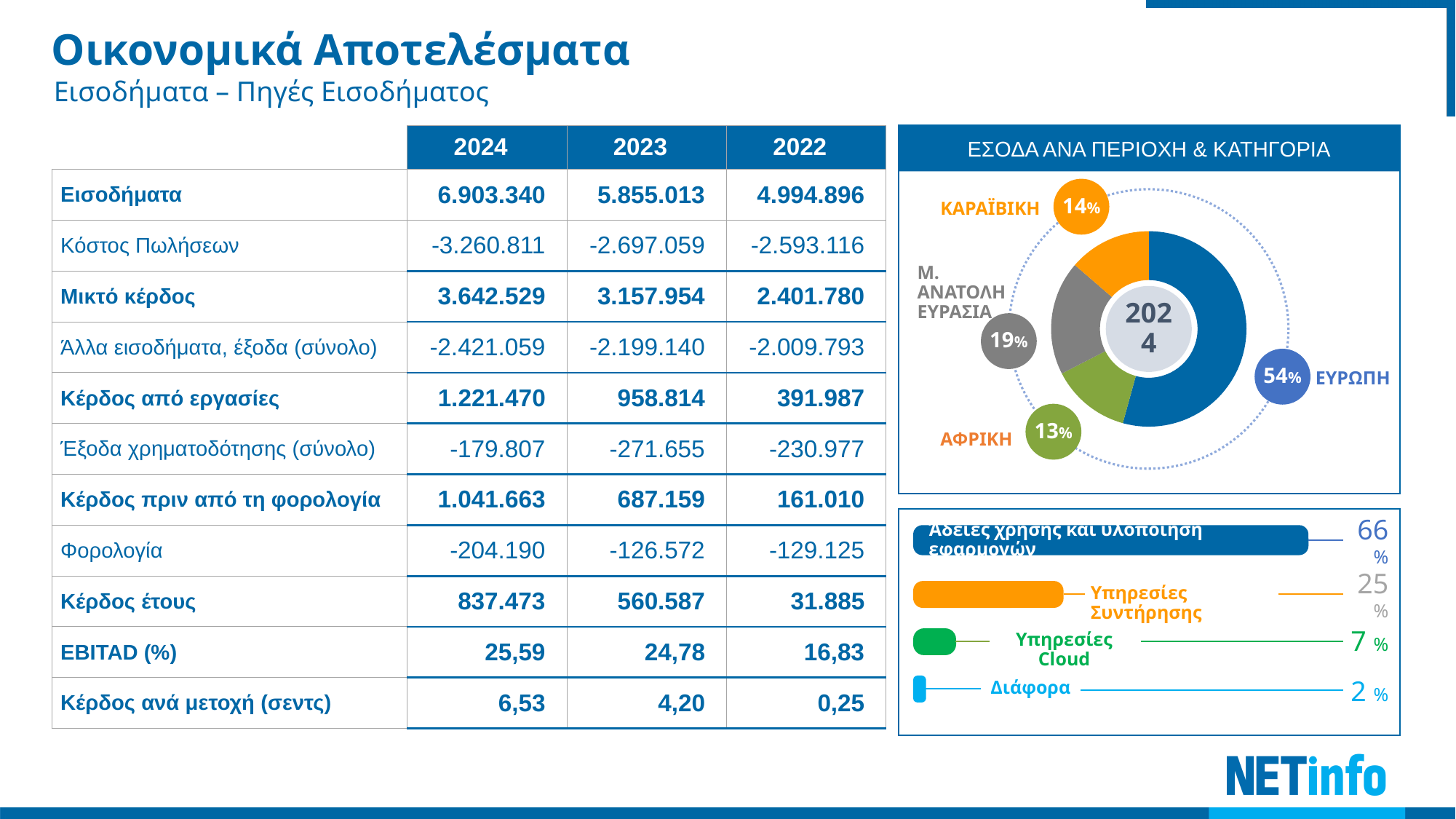
In the pie chart titled ΕΣΟΔΑ ΑΝΑ ΠΕΡΙΟΧΗ & ΚΑΤΗΓΟΡΙΑ, what share of revenue comes from ΕΥΡΩΠΗ? 54% In the pie chart titled ΕΣΟΔΑ ΑΝΑ ΠΕΡΙΟΧΗ & ΚΑΤΗΓΟΡΙΑ, what is the difference in percentage points between Μ. ΑΝΑΤΟΛΗ ΕΥΡΑΣΙΑ and ΚΑΡΑΪΒΙΚΗ? 5 In the bar chart at the bottom right of the slide, what percentage is shown for Υπηρεσίες Συντήρησης? 25% In the pie chart titled ΕΣΟΔΑ ΑΝΑ ΠΕΡΙΟΧΗ & ΚΑΤΗΓΟΡΙΑ, how many regions are shown? 4 What kind of chart is the one at the bottom right of the slide? Bar chart In the bar chart at the bottom right of the slide, which category has the highest percentage? Άδειες χρήσης και υλοποίηση εφαρμογών In the bar chart at the bottom right of the slide, which category has the lowest percentage? Διάφορα In the pie chart titled ΕΣΟΔΑ ΑΝΑ ΠΕΡΙΟΧΗ & ΚΑΤΗΓΟΡΙΑ, what year is shown in the centre of the chart? 2024 In the bar chart at the bottom right of the slide, what percentage is shown for Υπηρεσίες Cloud? 7% In the pie chart titled ΕΣΟΔΑ ΑΝΑ ΠΕΡΙΟΧΗ & ΚΑΤΗΓΟΡΙΑ, which region has the smallest share? ΑΦΡΙΚΗ In the pie chart titled ΕΣΟΔΑ ΑΝΑ ΠΕΡΙΟΧΗ & ΚΑΤΗΓΟΡΙΑ, what share is shown for ΑΦΡΙΚΗ? 13% In the pie chart titled ΕΣΟΔΑ ΑΝΑ ΠΕΡΙΟΧΗ & ΚΑΤΗΓΟΡΙΑ, which region has the largest share? ΕΥΡΩΠΗ